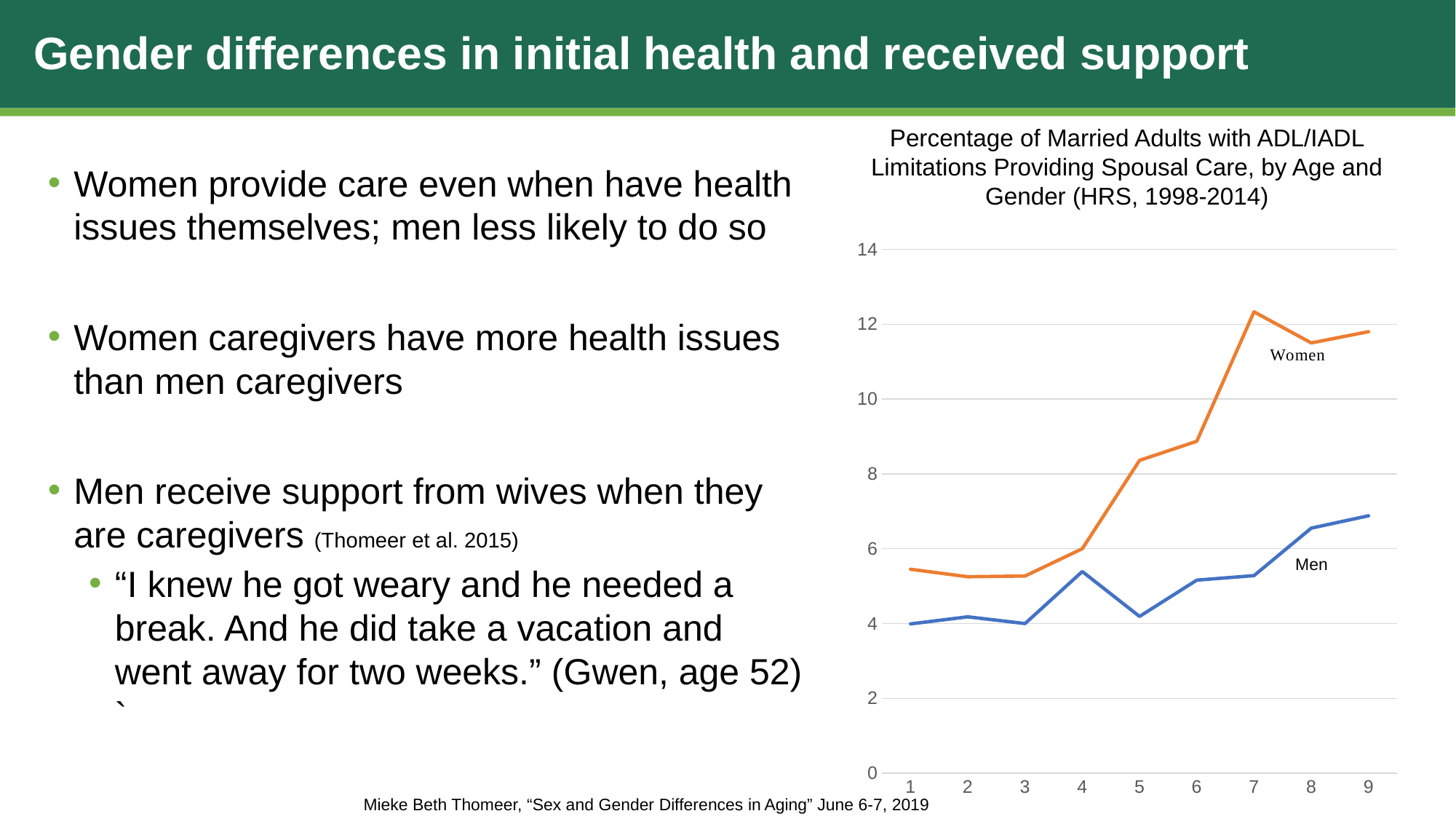
Is the value for Men at point 9 greater or less than 6? greater Which colour is used for the Women series? orange Is the value for Women at point 9 greater or less than 10? greater Does the Women series generally rise or fall from point 1 to point 9? rise At which x-axis point does the Women series reach its highest value? 7 What kind of chart is shown on the slide? line chart How many points are plotted along the x axis for each series? 9 Is the value for Women at point 7 greater or less than 12? greater At which x-axis point does the Men series reach its highest value? 9 How many series does the chart show? 2 At point 7, which series has the larger value, Women or Men? Women